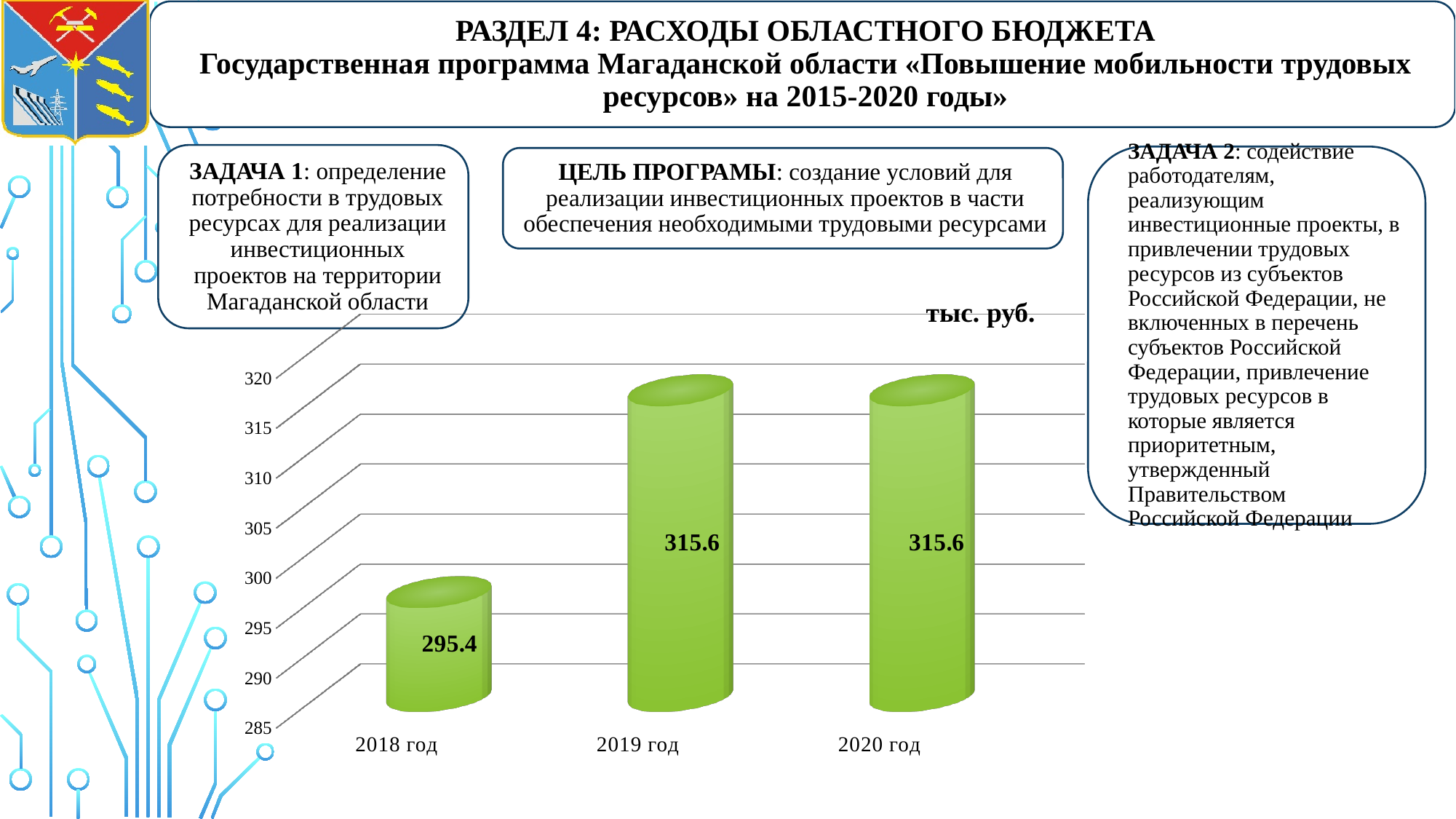
Which year has the lowest value? 2018 год What is the value for 2018 год? 295.4 What is the difference between the values for 2019 год and 2018 год? 20.2 Do the values rise or fall from 2018 год to 2019 год? rise Is the value for 2019 год greater or less than 310? greater What kind of chart is shown on the slide? bar chart What is the value for 2019 год? 315.6 What unit is indicated above the chart? тыс. руб. Which is larger, the value for 2018 год or the value for 2020 год? 2020 год How many years are shown on the chart? 3 What is the value for 2020 год? 315.6 Is the value for 2018 год greater or less than 300? less